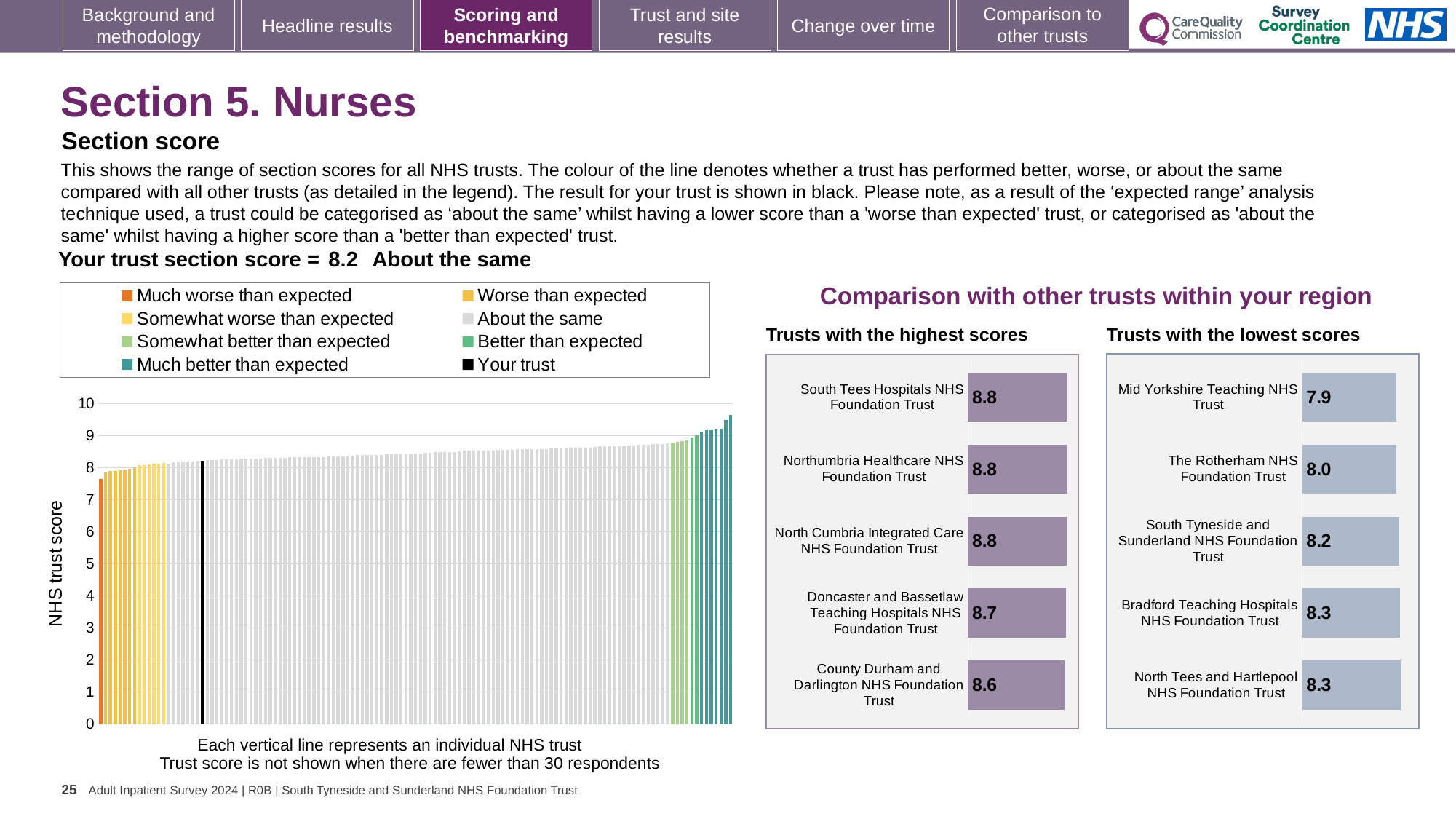
How many entries does the legend above the large chart on the left list? 8 In the 'Trusts with the lowest scores' chart, which trust has the lowest score? Mid Yorkshire Teaching NHS Trust In the large chart on the left, is the value of the tallest bar greater or less than 9? greater In the 'Trusts with the highest scores' chart, what is the score for County Durham and Darlington NHS Foundation Trust? 8.6 In the 'Trusts with the highest scores' chart, what is the difference between the scores of South Tees Hospitals NHS Foundation Trust and County Durham and Darlington NHS Foundation Trust? 0.2 In the large chart on the left, what is the section score for your trust (the black bar)? 8.2 What kind of chart is the large chart on the left showing NHS trust scores? Bar chart How many trusts are listed in the 'Trusts with the highest scores' chart? 5 In the 'Trusts with the lowest scores' chart, what is the difference between the scores of North Tees and Hartlepool NHS Foundation Trust and Mid Yorkshire Teaching NHS Trust? 0.4 In the 'Trusts with the lowest scores' chart, what is the score for Mid Yorkshire Teaching NHS Trust? 7.9 In the large chart on the left, do the trust scores rise or fall from left to right? Rise In the 'Trusts with the lowest scores' chart, which has the higher score: The Rotherham NHS Foundation Trust or South Tyneside and Sunderland NHS Foundation Trust? South Tyneside and Sunderland NHS Foundation Trust